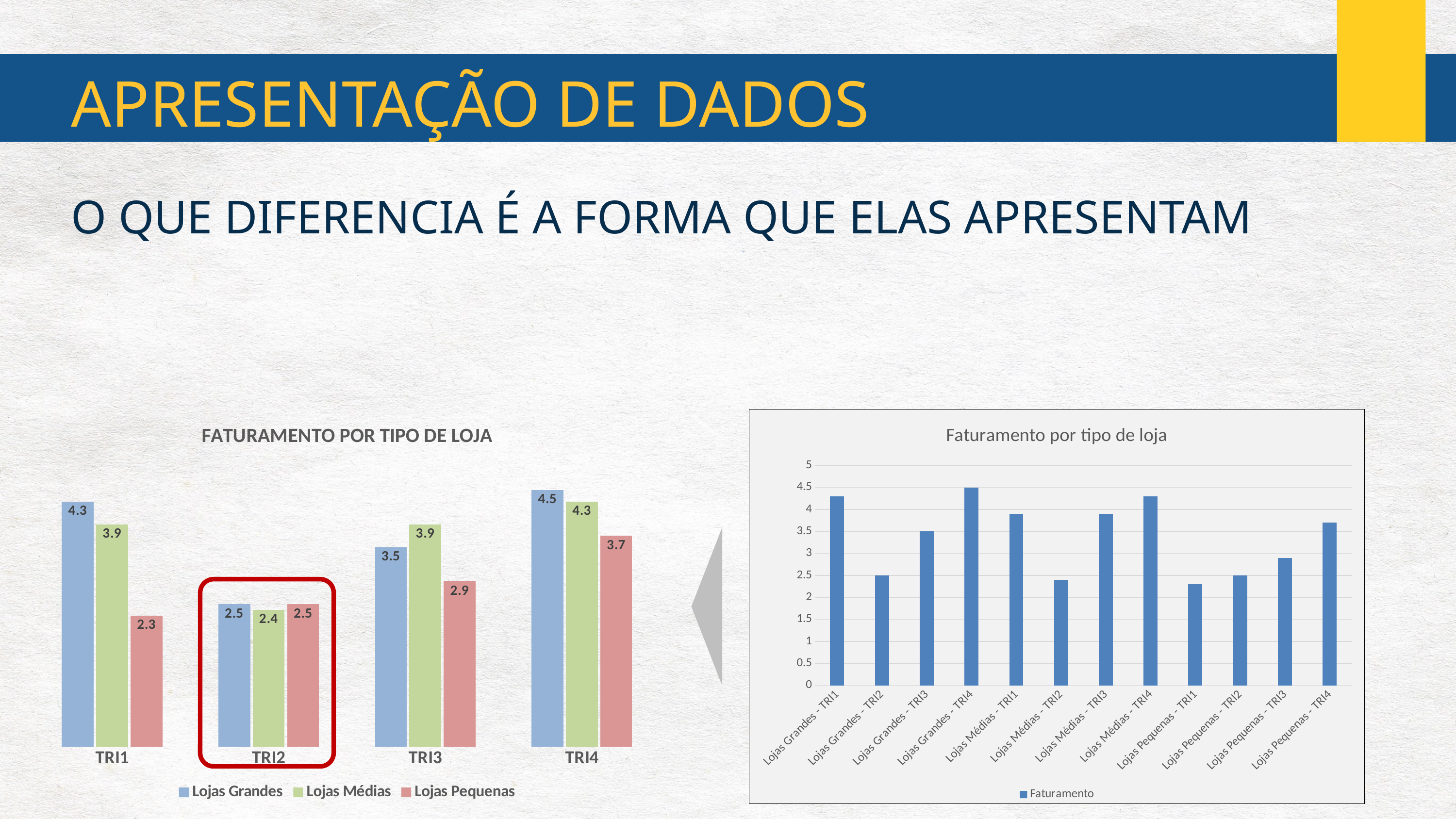
In the left chart 'FATURAMENTO POR TIPO DE LOJA', which is larger in TRI3: Lojas Grandes or Lojas Médias? Lojas Médias How many series does the legend of the left chart 'FATURAMENTO POR TIPO DE LOJA' list? 3 In the right chart 'Faturamento por tipo de loja', is the value for Lojas Médias - TRI1 greater or less than 3.5? greater In the left chart 'FATURAMENTO POR TIPO DE LOJA', what is the value for Lojas Pequenas in TRI3? 2.9 How many quarters are shown on the x axis of the left chart 'FATURAMENTO POR TIPO DE LOJA'? 4 What kind of chart is the right chart 'Faturamento por tipo de loja'? Bar chart In the left chart 'FATURAMENTO POR TIPO DE LOJA', which quarter has the highest value for Lojas Grandes? TRI4 How many bars are plotted in the right chart 'Faturamento por tipo de loja'? 12 In the left chart 'FATURAMENTO POR TIPO DE LOJA', what is the value for Lojas Grandes in TRI1? 4.3 In the left chart 'FATURAMENTO POR TIPO DE LOJA', what is the difference between Lojas Grandes and Lojas Pequenas in TRI1? 2.0 In the left chart 'FATURAMENTO POR TIPO DE LOJA', which quarter has the lowest value for Lojas Médias? TRI2 In the right chart 'Faturamento por tipo de loja', is the value for Lojas Pequenas - TRI1 greater or less than 2.5? less